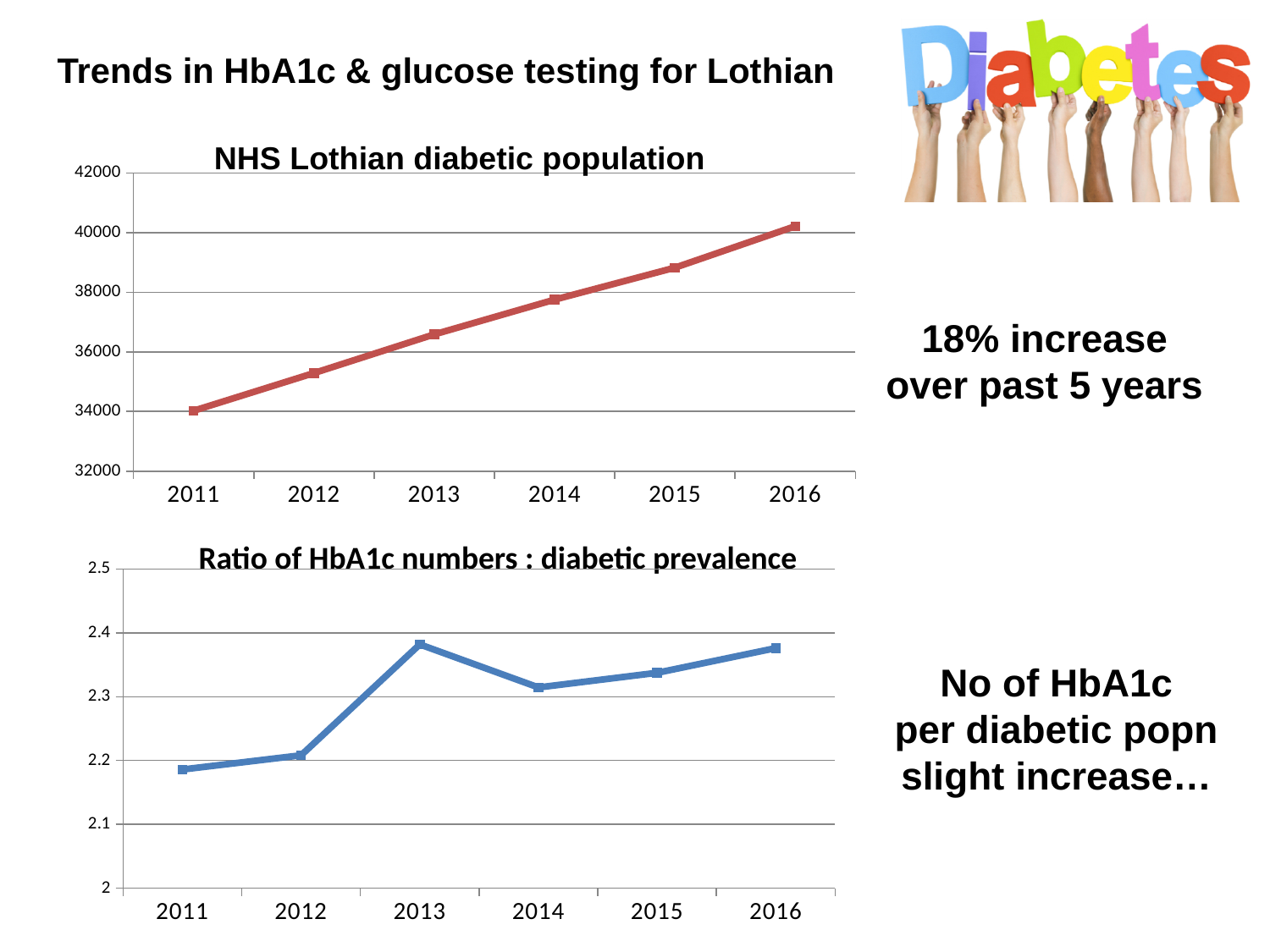
In the 'NHS Lothian diabetic population' chart, do the values rise or fall from 2011 to 2016? rise In the 'NHS Lothian diabetic population' chart, which year has the lowest value? 2011 In the 'Ratio of HbA1c numbers : diabetic prevalence' chart, which is larger, the value for 2013 or the value for 2014? 2013 In the 'Ratio of HbA1c numbers : diabetic prevalence' chart, which year has the highest value? 2013 What type of chart is the 'NHS Lothian diabetic population' chart? line chart In the 'NHS Lothian diabetic population' chart, which year has the highest value? 2016 In the 'Ratio of HbA1c numbers : diabetic prevalence' chart, which year has the lowest value? 2011 In the 'Ratio of HbA1c numbers : diabetic prevalence' chart, is the value for 2012 greater or less than 2.3? less In the 'NHS Lothian diabetic population' chart, how many years are plotted on the x axis? 6 In the 'NHS Lothian diabetic population' chart, is the value for 2016 greater or less than 40000? greater In the 'NHS Lothian diabetic population' chart, is the value for 2013 greater or less than 36000? greater What is the title of the bottom chart on the slide? Ratio of HbA1c numbers : diabetic prevalence